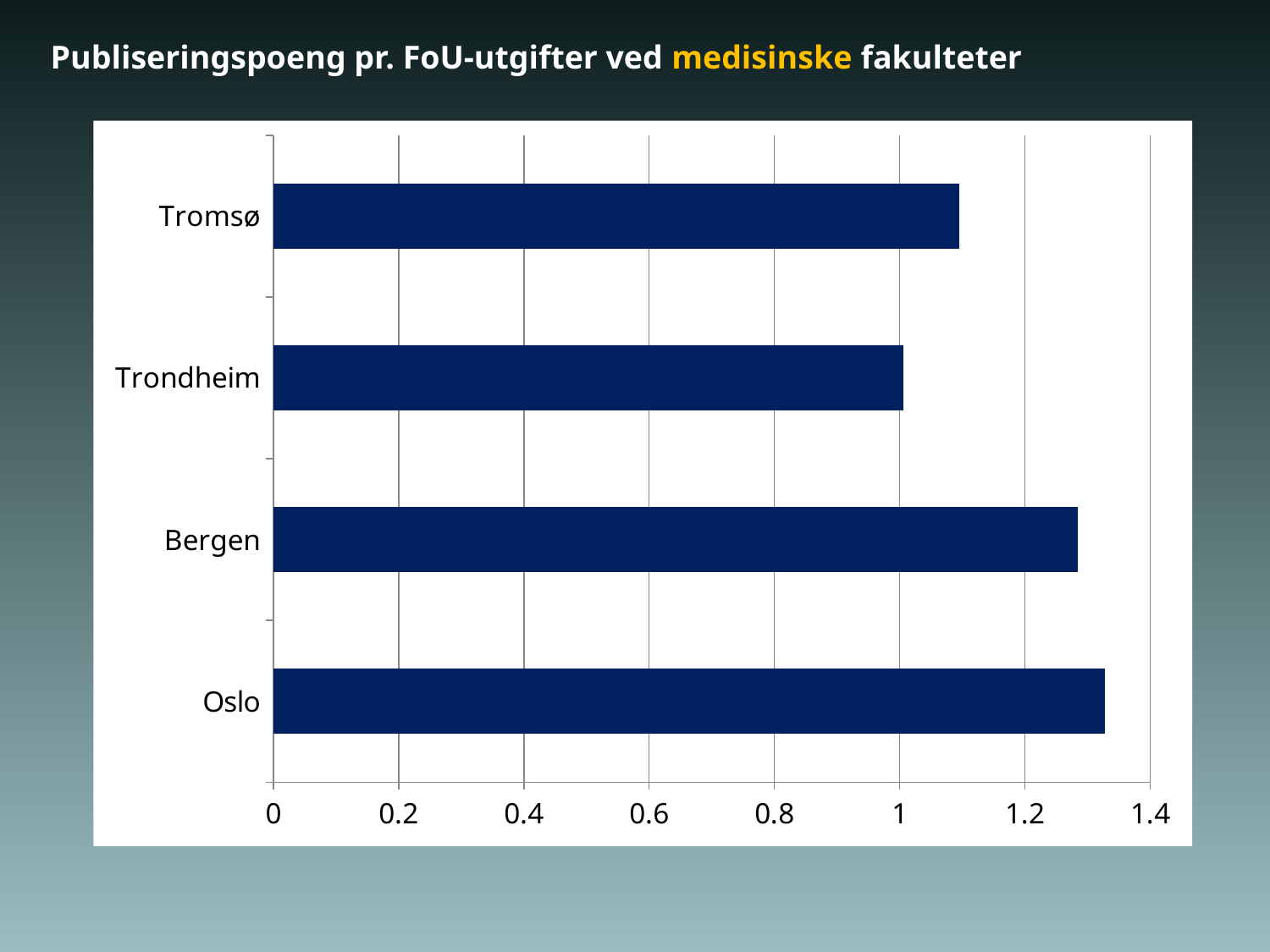
Is the value for Tromsø greater or less than 1? greater Is the value for Oslo greater or less than 1.4? less Which city has the lowest value in the chart? Trondheim Is the value for Bergen greater or less than 1.2? greater Which city has the highest value in the chart? Oslo Which has the larger value, Bergen or Tromsø? Bergen How many categories (cities) are shown in the chart? 4 Which has the larger value, Tromsø or Trondheim? Tromsø What is the title of the slide above the chart? Publiseringspoeng pr. FoU-utgifter ved medisinske fakulteter What kind of chart is shown on the slide? bar chart